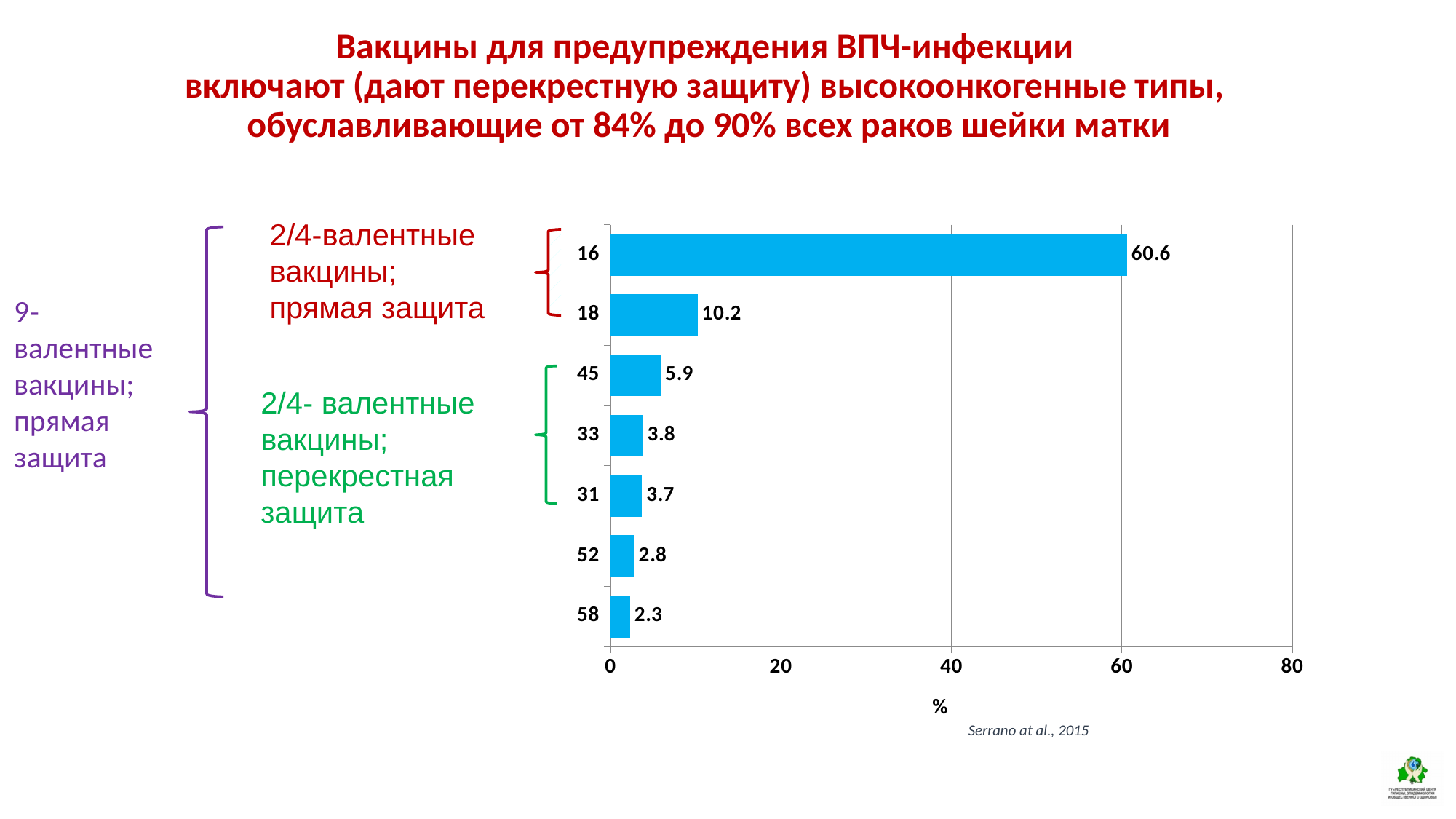
What is the label on the horizontal axis of the chart? % What is the difference between the values for type 16 and type 18? 50.4 Which has a larger value, type 33 or type 52? 33 What kind of chart is shown on the slide? bar chart What is the value for HPV type 58? 2.3 Which HPV type has the lowest value? 58 Which HPV type has the highest value? 16 How many HPV types are shown in the chart? 7 What is the value for HPV type 16? 60.6 What is the value for HPV type 45? 5.9 What is the value for HPV type 18? 10.2 Is the value for type 16 greater or less than 60? greater